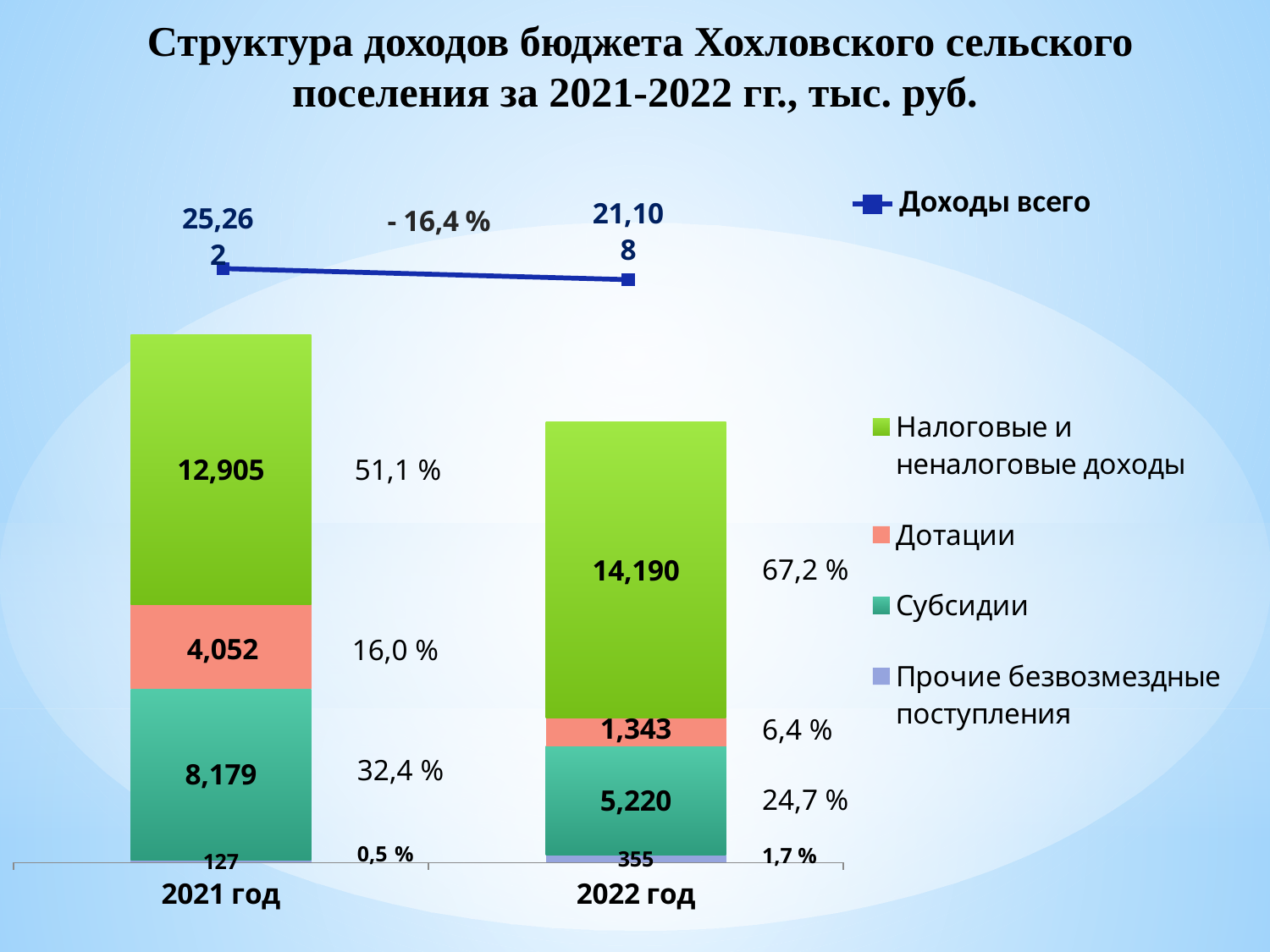
How many series does the legend list? 5 What is the value of Доходы всего for 2022 год? 21,108 Which component of the 2021 год bar is the largest? Налоговые и неналоговые доходы What is the value of Налоговые и неналоговые доходы for 2021 год? 12,905 What is the value of Прочие безвозмездные поступления for 2021 год? 127 What percentage share is shown next to Налоговые и неналоговые доходы for 2022 год? 67,2 % Which component of the 2022 год bar is the smallest? Прочие безвозмездные поступления What is the difference between Дотации in 2021 год and Дотации in 2022 год? 2,709 What percentage change in Доходы всего is shown between 2021 год and 2022 год? - 16,4 % What is the value of Субсидии for 2022 год? 5,220 What is the value of Дотации for 2022 год? 1,343 Which is larger: Субсидии in 2021 год or Субсидии in 2022 год? Субсидии in 2021 год